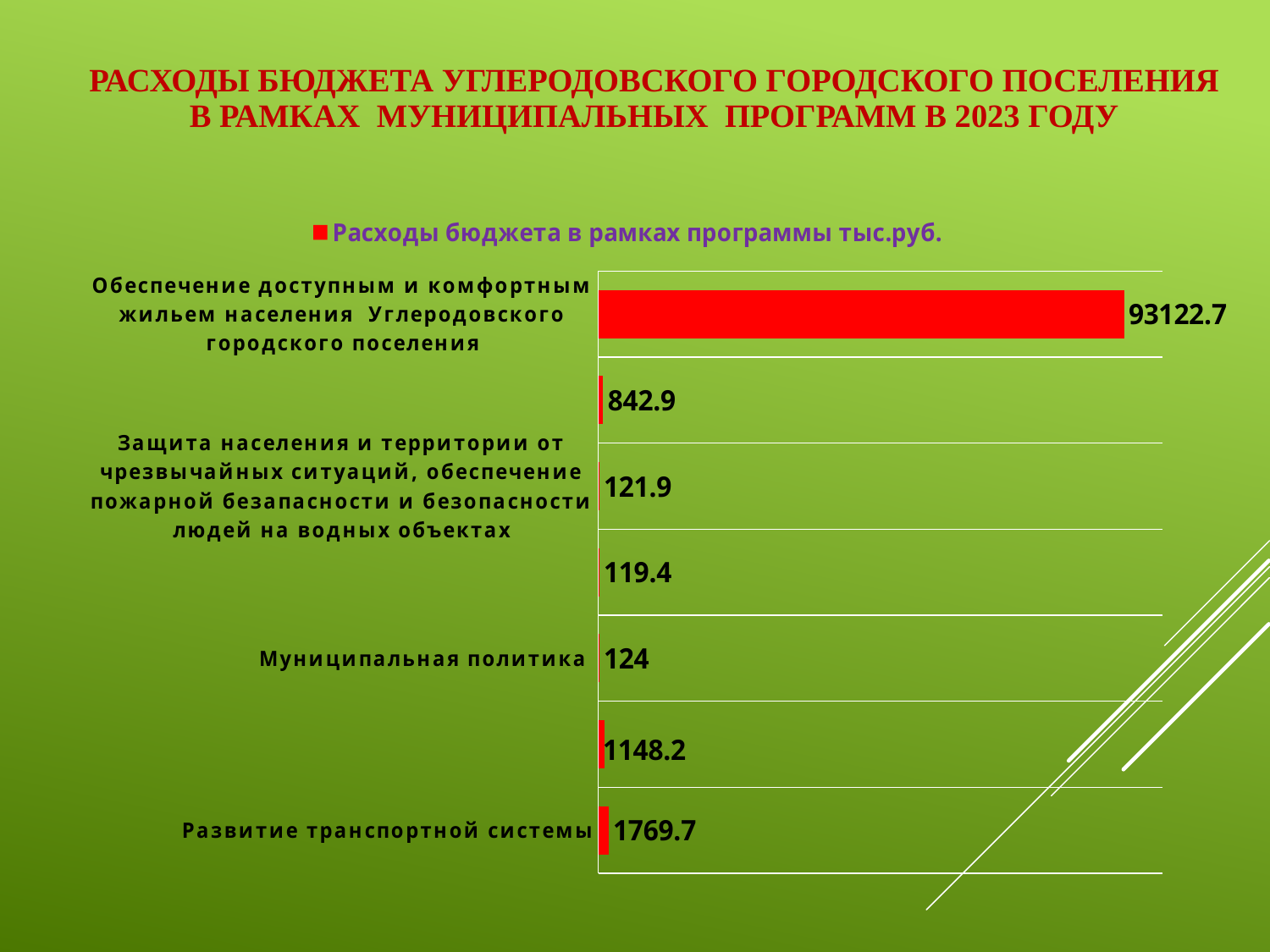
What is the value for "Муниципальная политика"? 124 What is the value for "Защита населения и территории от чрезвычайных ситуаций, обеспечение пожарной безопасности и безопасности людей на водных объектах"? 121.9 Which category has the highest value? Обеспечение доступным и комфортным жильем населения Углеродовского городского поселения What is the value for "Обеспечение доступным и комфортным жильем населения Углеродовского городского поселения"? 93122.7 How many series does the legend list? 1 What is the value for "Развитие транспортной системы"? 1769.7 Which is larger: the value for "Муниципальная политика" or the value for "Защита населения и территории от чрезвычайных ситуаций, обеспечение пожарной безопасности и безопасности людей на водных объектах"? Муниципальная политика What is the smallest value shown on the chart? 119.4 How many bars are plotted on the chart? 7 What is the difference between the values for "Обеспечение доступным и комфортным жильем населения Углеродовского городского поселения" and "Развитие транспортной системы"? 91353 What is the difference between the values for "Развитие транспортной системы" and "Муниципальная политика"? 1645.7 What kind of chart is shown on the slide? bar chart